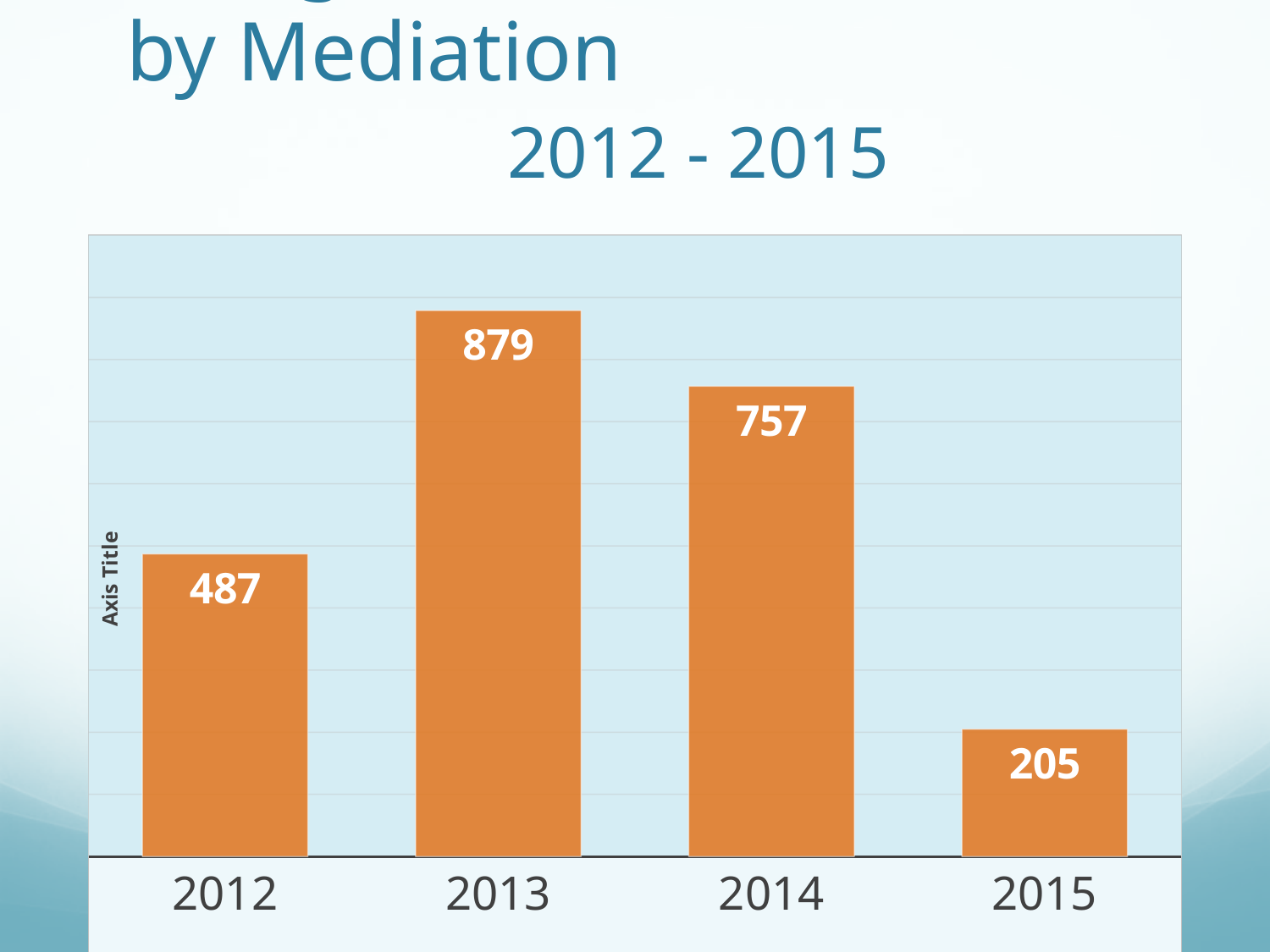
Which year has the lowest value? 2015 What is the value for 2012? 487 What is the value for 2015? 205 Do the values rise or fall from 2013 to 2015? Fall What is the difference between the values for 2013 and 2014? 122 What kind of chart is shown on the slide? Bar chart How many years are shown on the x axis? 4 Which is larger, the value for 2012 or the value for 2014? 2014 What is the value for 2014? 757 What is the difference between the values for 2012 and 2015? 282 Which year has the highest value? 2013 What is the value for 2013? 879